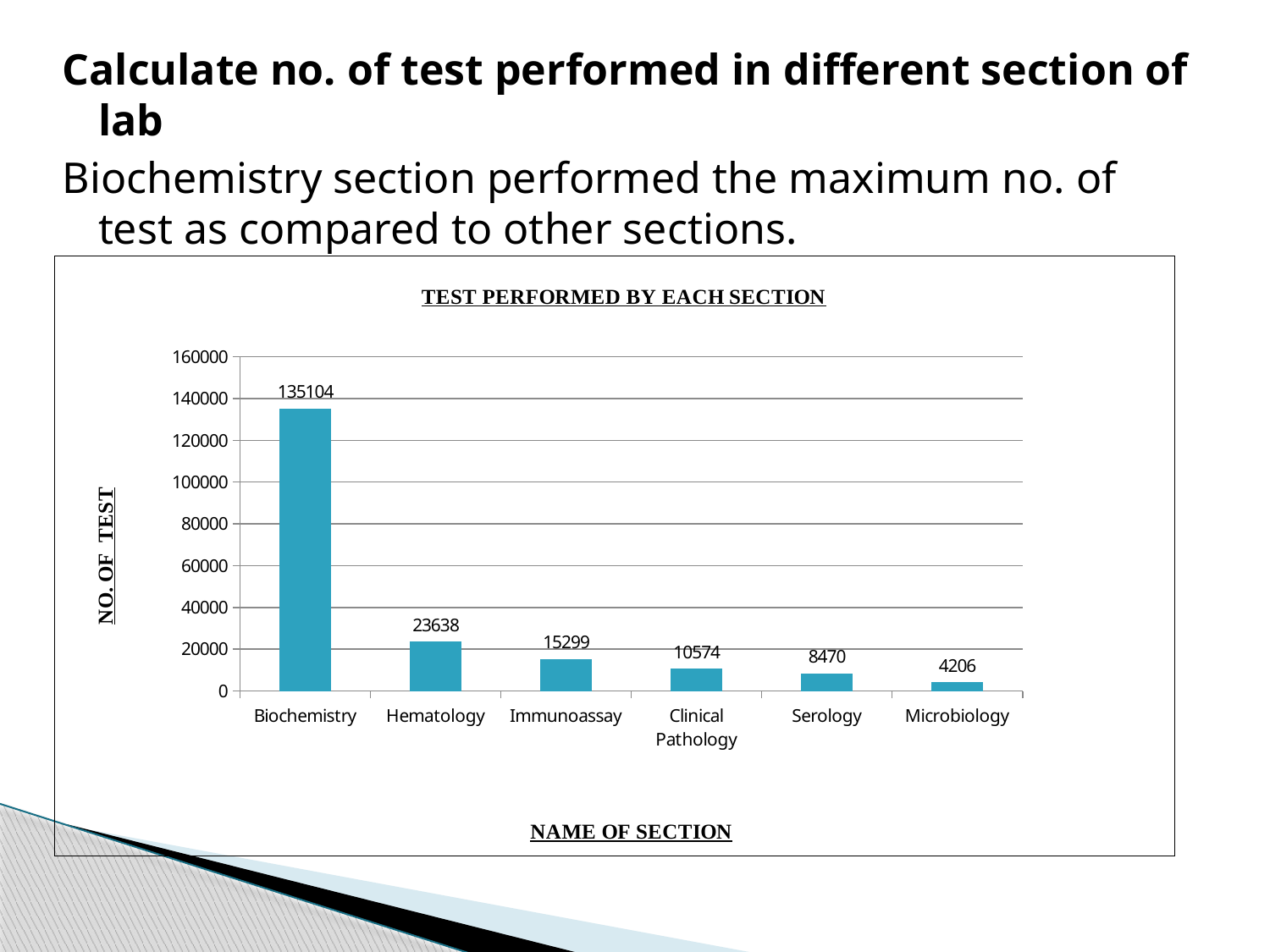
Which is larger, the value for Clinical Pathology or the value for Serology? Clinical Pathology What is the value shown for Hematology? 23638 How many sections are shown on the x axis? 6 Do the values rise or fall from left to right along the x axis? fall What kind of chart is shown on the slide? bar chart What is the value shown for Serology? 8470 What is the difference between the values for Hematology and Immunoassay? 8339 What is the title of the chart? TEST PERFORMED BY EACH SECTION Which section performed the most tests? Biochemistry How many tests were performed by the Biochemistry section? 135104 Which section performed the fewest tests? Microbiology Is the value for Immunoassay greater or less than 20000? less